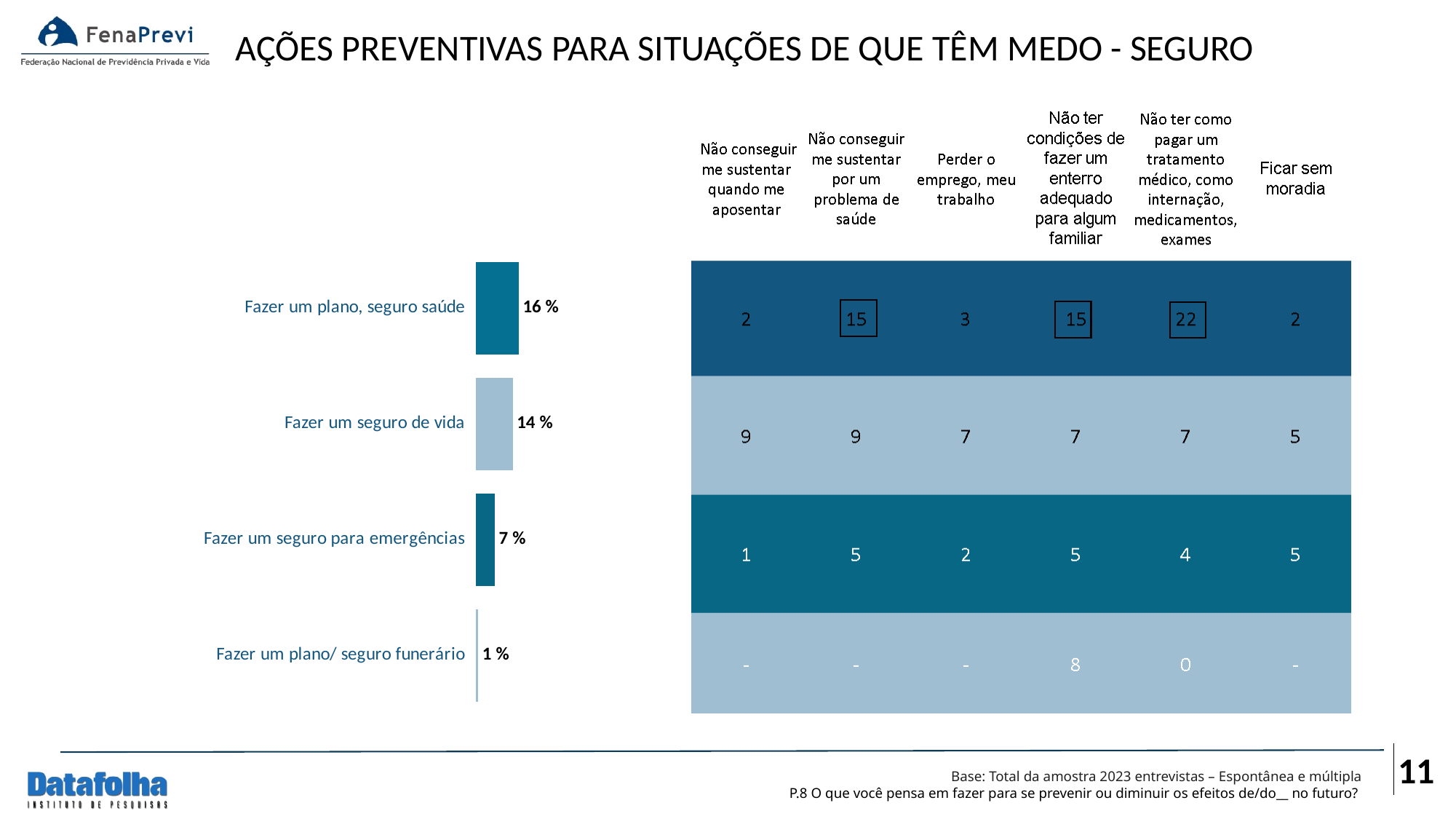
What kind of chart is shown on the left of the slide? Bar chart What is the value for "Fazer um seguro de vida" in the bar chart? 14 % How many categories are shown in the bar chart? 4 What is the title of the slide? AÇÕES PREVENTIVAS PARA SITUAÇÕES DE QUE TÊM MEDO - SEGURO In the table on the right, what is the value for "Fazer um plano, seguro saúde" under "Não ter como pagar um tratamento médico, como internação, medicamentos, exames"? 22 Which category has the highest value in the bar chart? Fazer um plano, seguro saúde What is the value for "Fazer um plano/ seguro funerário" in the bar chart? 1 % What is the value for "Fazer um seguro para emergências" in the bar chart? 7 % Which category has the lowest value in the bar chart? Fazer um plano/ seguro funerário Which is larger: the value for "Fazer um seguro de vida" or for "Fazer um seguro para emergências"? Fazer um seguro de vida What is the difference between the values for "Fazer um plano, seguro saúde" and "Fazer um seguro de vida"? 2 % What is the value for "Fazer um plano, seguro saúde" in the bar chart? 16 %